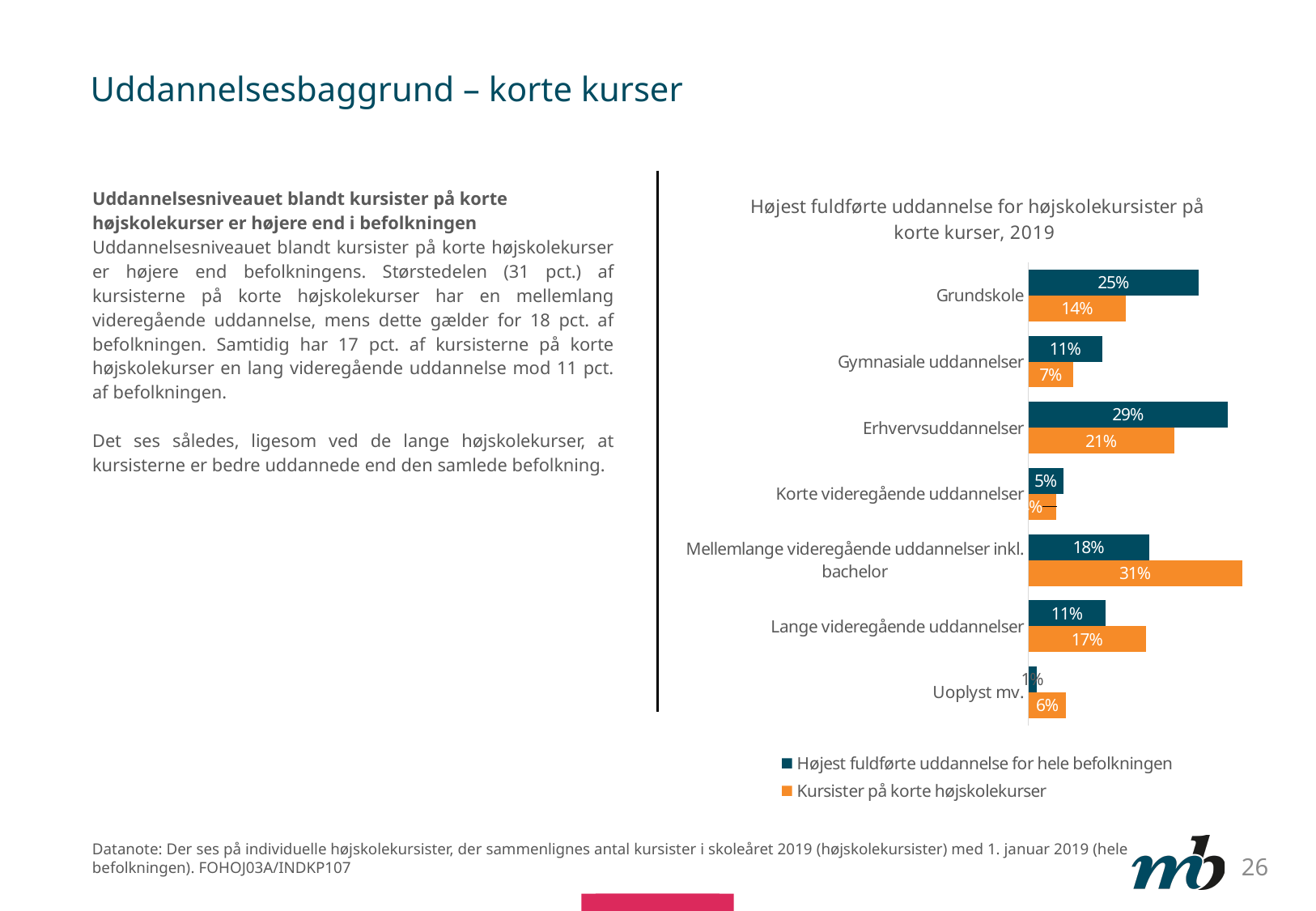
Which category has the highest value in the series 'Kursister på korte højskolekurser'? Mellemlange videregående uddannelser inkl. bachelor What is the value for Lange videregående uddannelser in the series 'Kursister på korte højskolekurser'? 17% What is the value for Grundskole in the series 'Højest fuldførte uddannelse for hele befolkningen'? 25% How many series does the legend list? 2 What kind of chart is shown on the slide? bar chart How many education categories are shown on the chart? 7 For Gymnasiale uddannelser, which series has the larger value? Højest fuldførte uddannelse for hele befolkningen What is the title of the chart? Højest fuldførte uddannelse for højskolekursister på korte kurser, 2019 What is the difference between the two series for Mellemlange videregående uddannelser inkl. bachelor? 13% Which category has the highest value in the series 'Højest fuldførte uddannelse for hele befolkningen'? Erhvervsuddannelser What is the difference between the two series for Erhvervsuddannelser? 8% What is the value for Mellemlange videregående uddannelser inkl. bachelor in the series 'Kursister på korte højskolekurser'? 31%